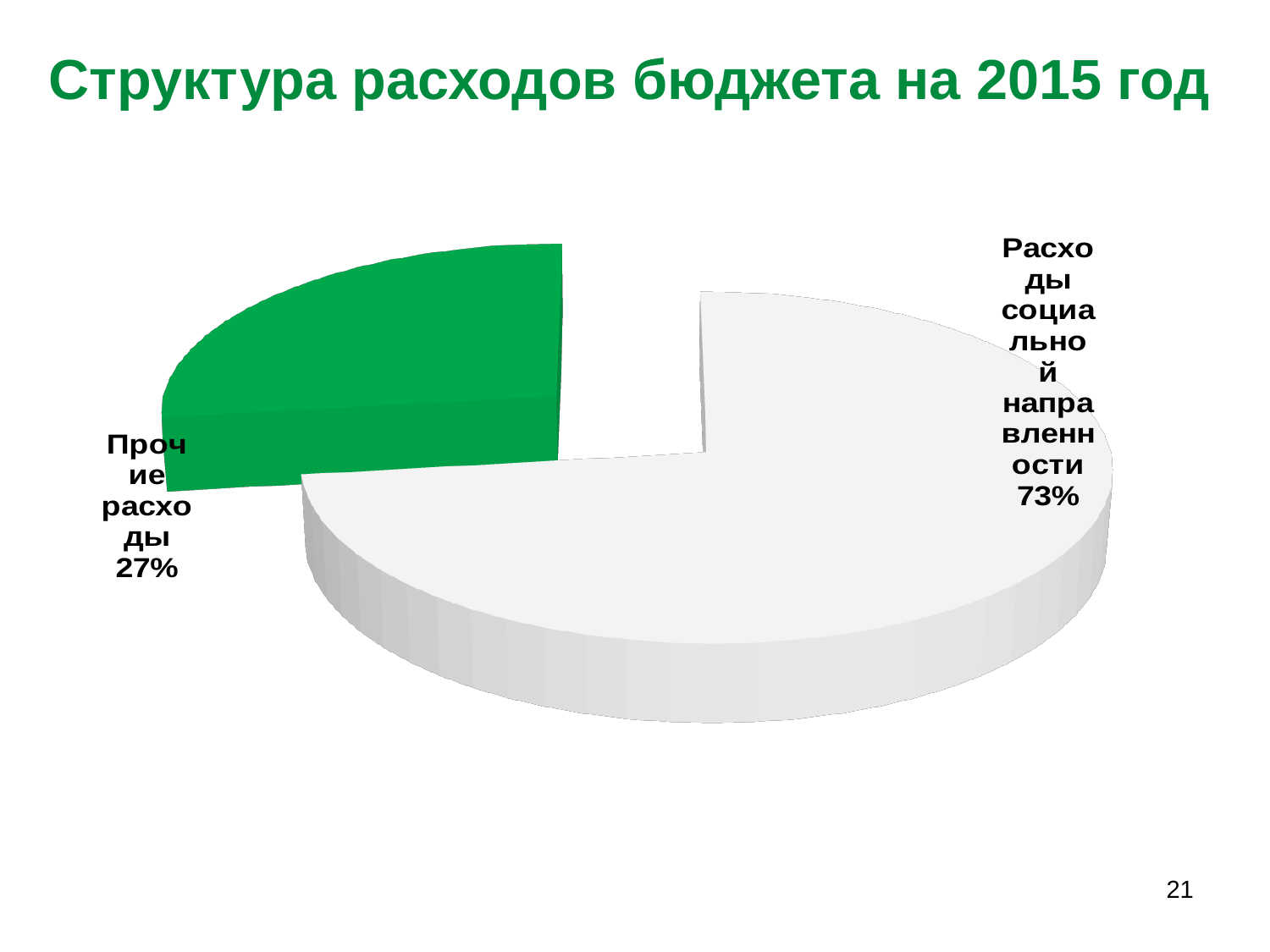
What is the title of the slide? Структура расходов бюджета на 2015 год Which is larger: "Прочие расходы" or "Расходы социальной направленности"? Расходы социальной направленности What is the difference in percentage points between "Расходы социальной направленности" and "Прочие расходы"? 46 Which slice of the pie is the largest? Расходы социальной направленности What colour is the "Прочие расходы" slice? Green Which slice of the pie is the smallest? Прочие расходы How many slices does the pie chart have? 2 Is the share for "Прочие расходы" greater or less than 50%? less What share of the pie does "Прочие расходы" represent? 27% What kind of chart is shown on the slide? Pie chart What share of the pie does "Расходы социальной направленности" represent? 73%